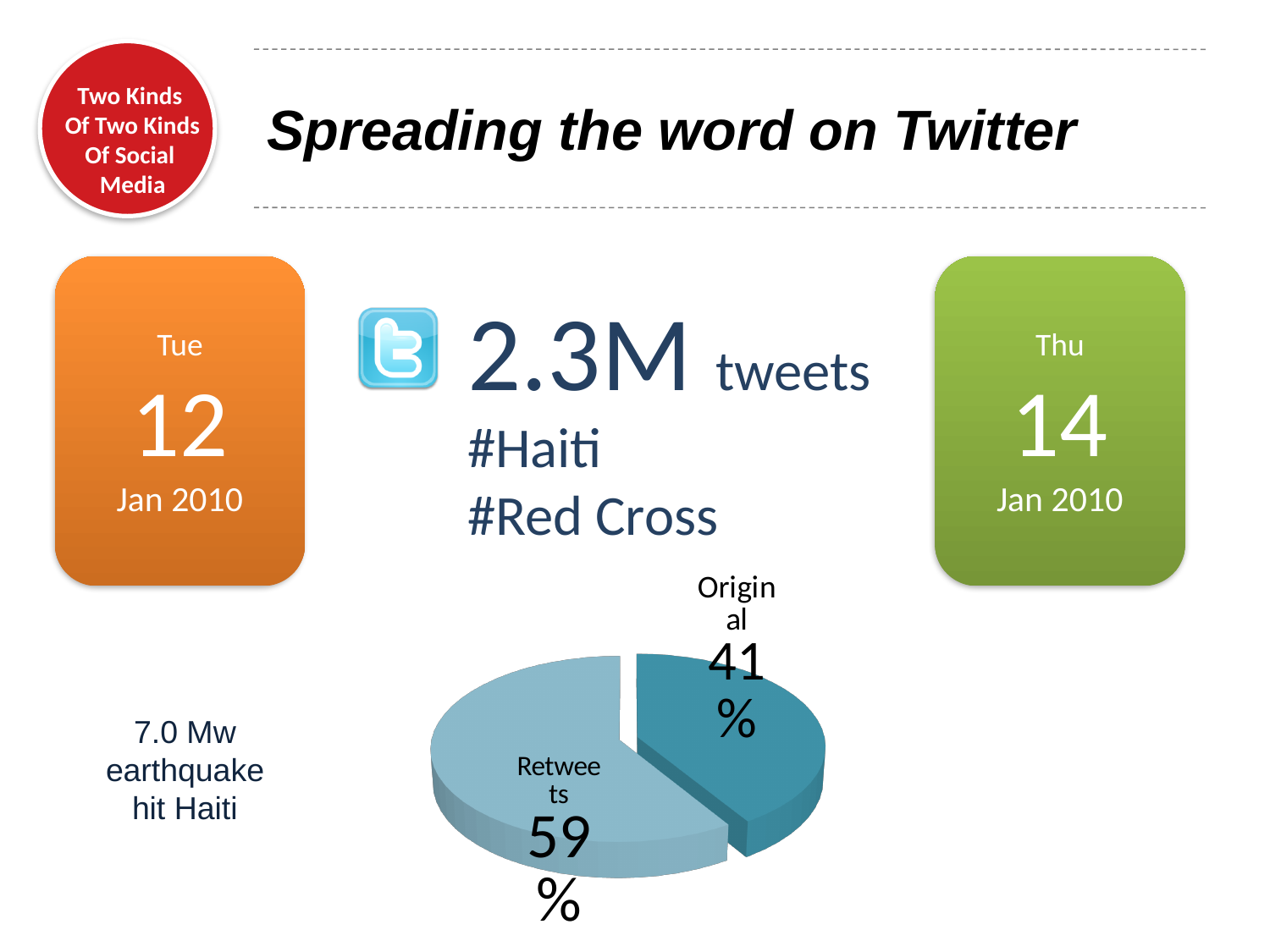
Which slice of the pie is the smallest? Original Is the pie chart drawn in 3D? yes How many slices does the pie chart have? 2 What share of the pie is labelled Original? 41% What share of the pie is labelled Retweets? 59% Which is larger, the Retweets slice or the Original slice? Retweets What kind of chart is shown on the slide? pie chart Which slice of the pie is drawn in the darker blue colour? Original Which slice of the pie is the largest? Retweets Is the Retweets share greater or less than 50%? greater What is the difference in percentage points between the Retweets slice and the Original slice? 18 Is the Original share greater or less than 50%? less